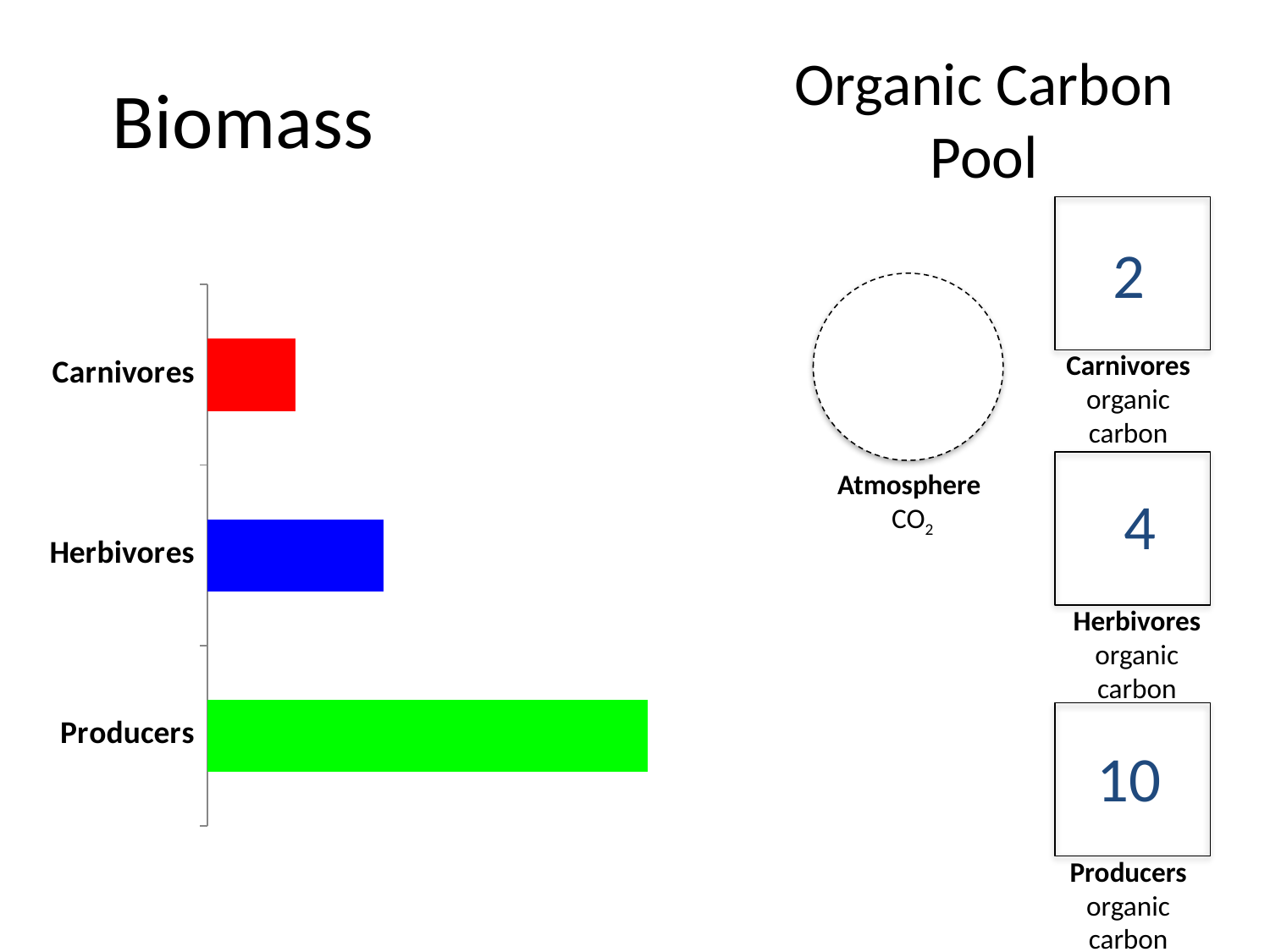
Which category has the shortest bar in the Biomass chart? Carnivores Which category has the longest bar in the Biomass chart? Producers What colour is the Producers bar in the Biomass chart? green How many categories does the Biomass bar chart show? 3 Are the bars in the Biomass chart horizontal or vertical? horizontal Which category is listed at the top of the Biomass chart? Carnivores In the Biomass chart, which has the larger bar, Herbivores or Carnivores? Herbivores What kind of chart is the Biomass chart? bar chart What is the title of the bar chart on the left of the slide? Biomass In the Biomass chart, which has the larger bar, Producers or Herbivores? Producers